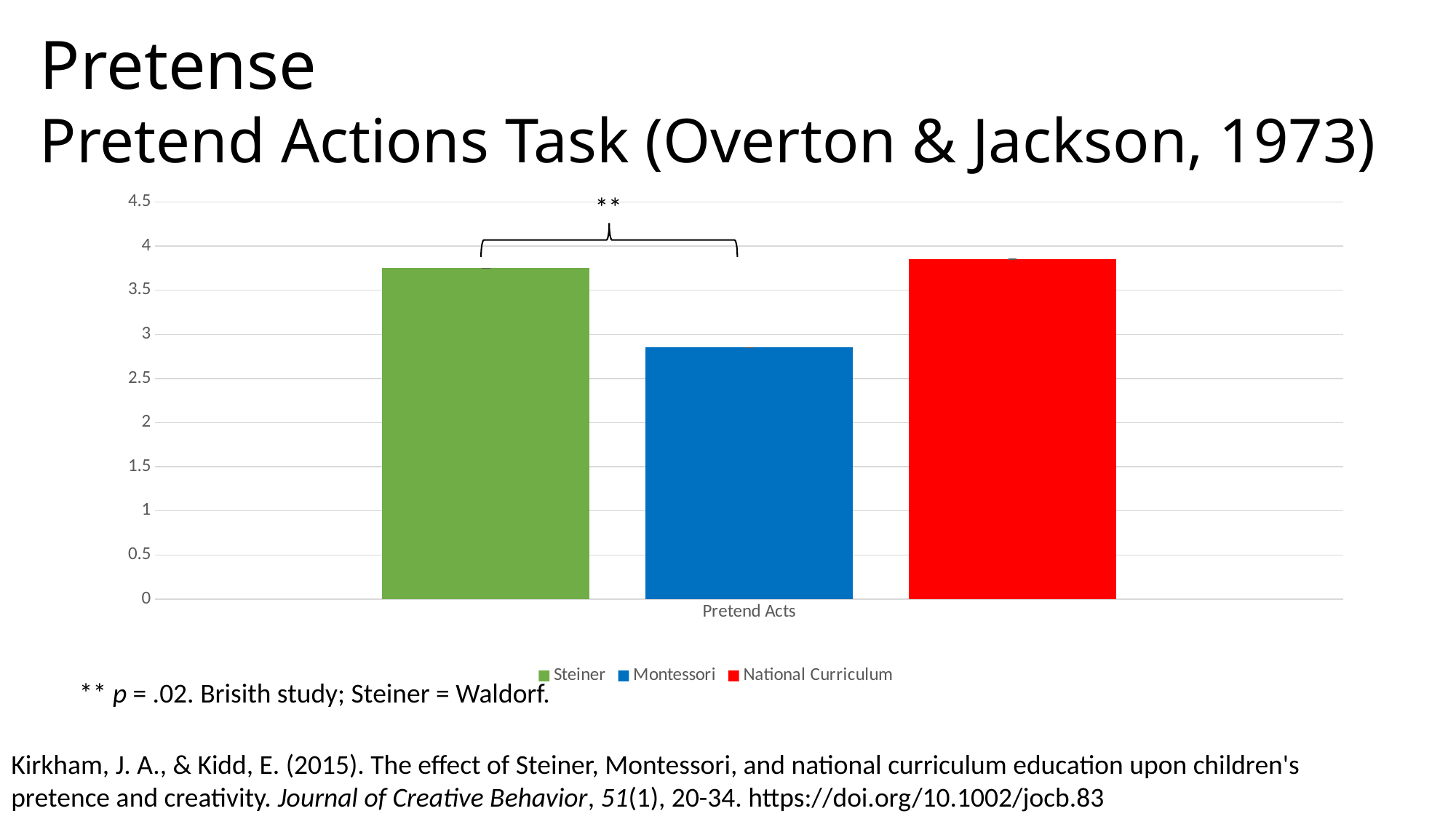
Is the value for Montessori greater or less than 2.5? greater Is the value for Montessori greater or less than 3? less Is the value for Steiner greater or less than 3.5? greater What kind of chart is shown on the slide? bar chart Which is larger, the value for National Curriculum or the value for Montessori? National Curriculum What colour is the bar for National Curriculum? red How many categories are shown on the x axis? 1 What is the category label shown on the x axis? Pretend Acts Which is larger, the value for Steiner or the value for Montessori? Steiner Which series has the lowest value for Pretend Acts? Montessori How many series does the legend list? 3